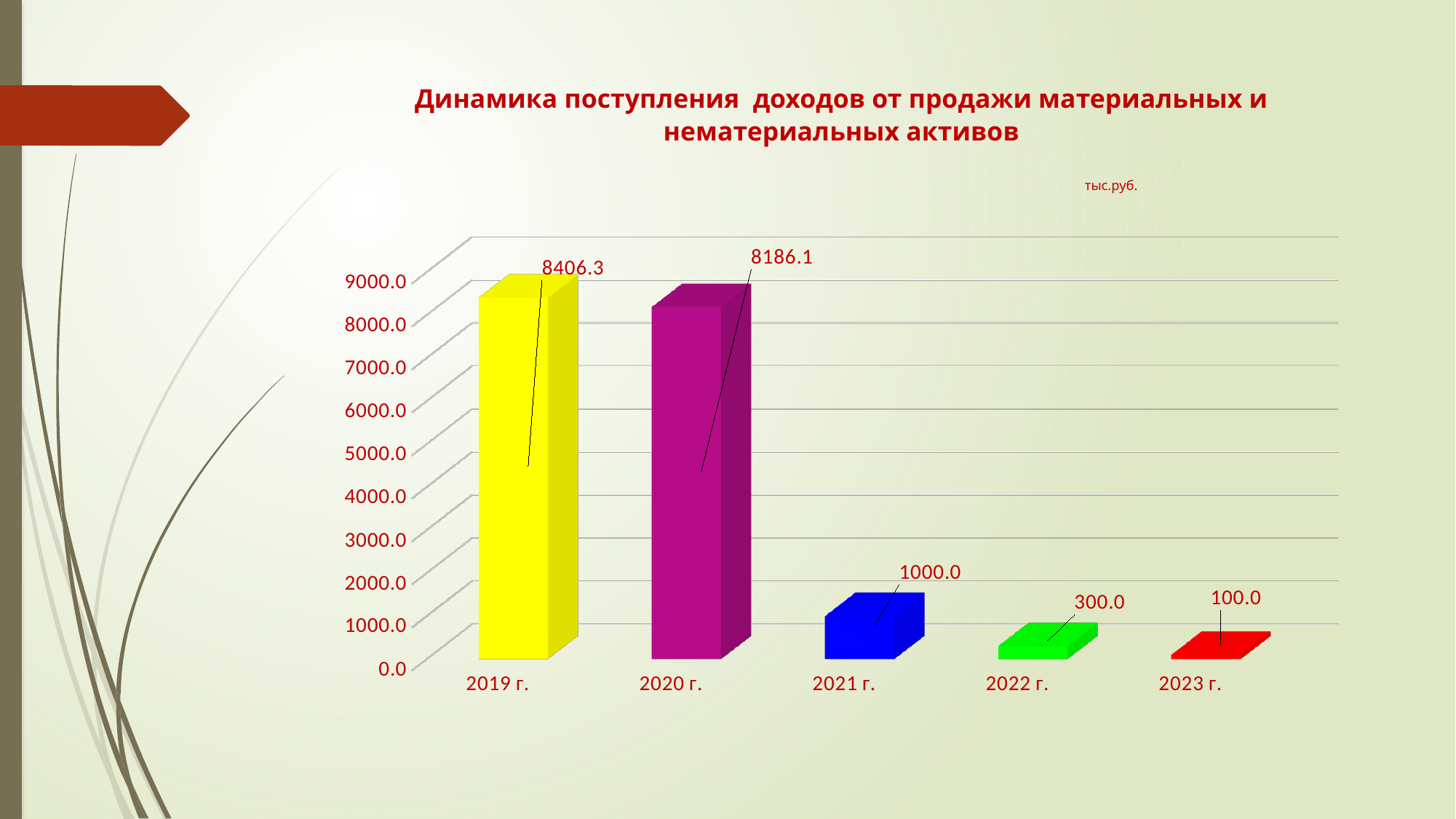
What is the value for 2022 г.? 300.0 What is the value for 2020 г.? 8186.1 What is the value for 2023 г.? 100.0 What is the value for 2019 г.? 8406.3 Which year has the highest value? 2019 г. What is the value for 2021 г.? 1000.0 Which is larger, the value for 2021 г. or the value for 2022 г.? 2021 г. What is the difference between the values for 2019 г. and 2020 г.? 220.2 Do the values rise or fall from 2019 г. to 2023 г.? Fall What kind of chart is shown on the slide? Bar chart How many years are shown on the x axis? 5 Which year has the lowest value? 2023 г.